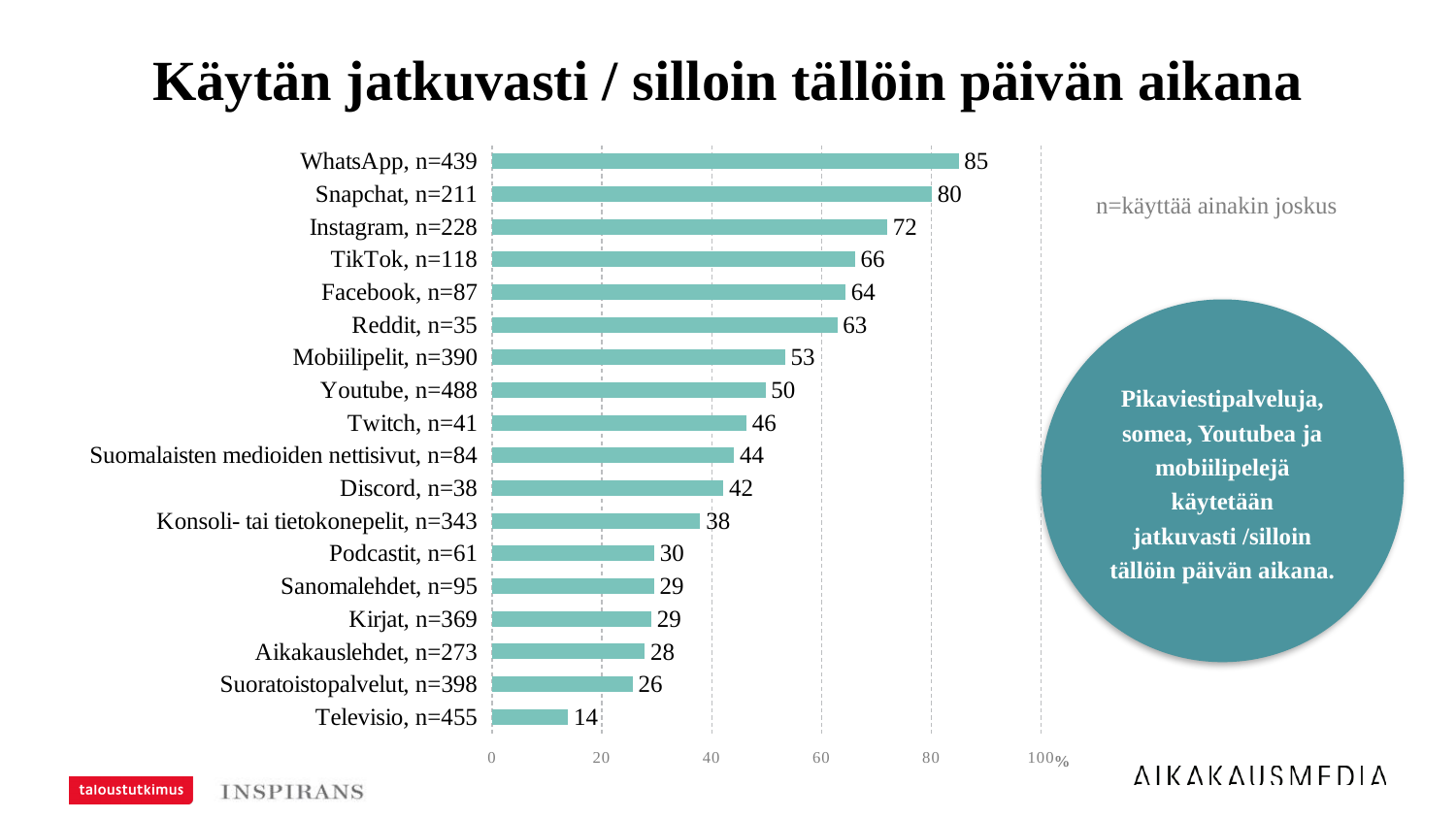
What kind of chart is shown on the slide? Bar chart What is the value for WhatsApp, n=439? 85 Which category has the lowest value? Televisio, n=455 What is the difference between the values for Snapchat, n=211 and Instagram, n=228? 8 How many categories are shown in the chart? 18 Which category has the highest value? WhatsApp, n=439 What is the value for Televisio, n=455? 14 What is the value for Discord, n=38? 42 What is the value for Mobiilipelit, n=390? 53 What is the difference between the values for WhatsApp, n=439 and Televisio, n=455? 71 Which has a higher value, Youtube, n=488 or Twitch, n=41? Youtube, n=488 What is the title of the chart? Käytän jatkuvasti / silloin tällöin päivän aikana